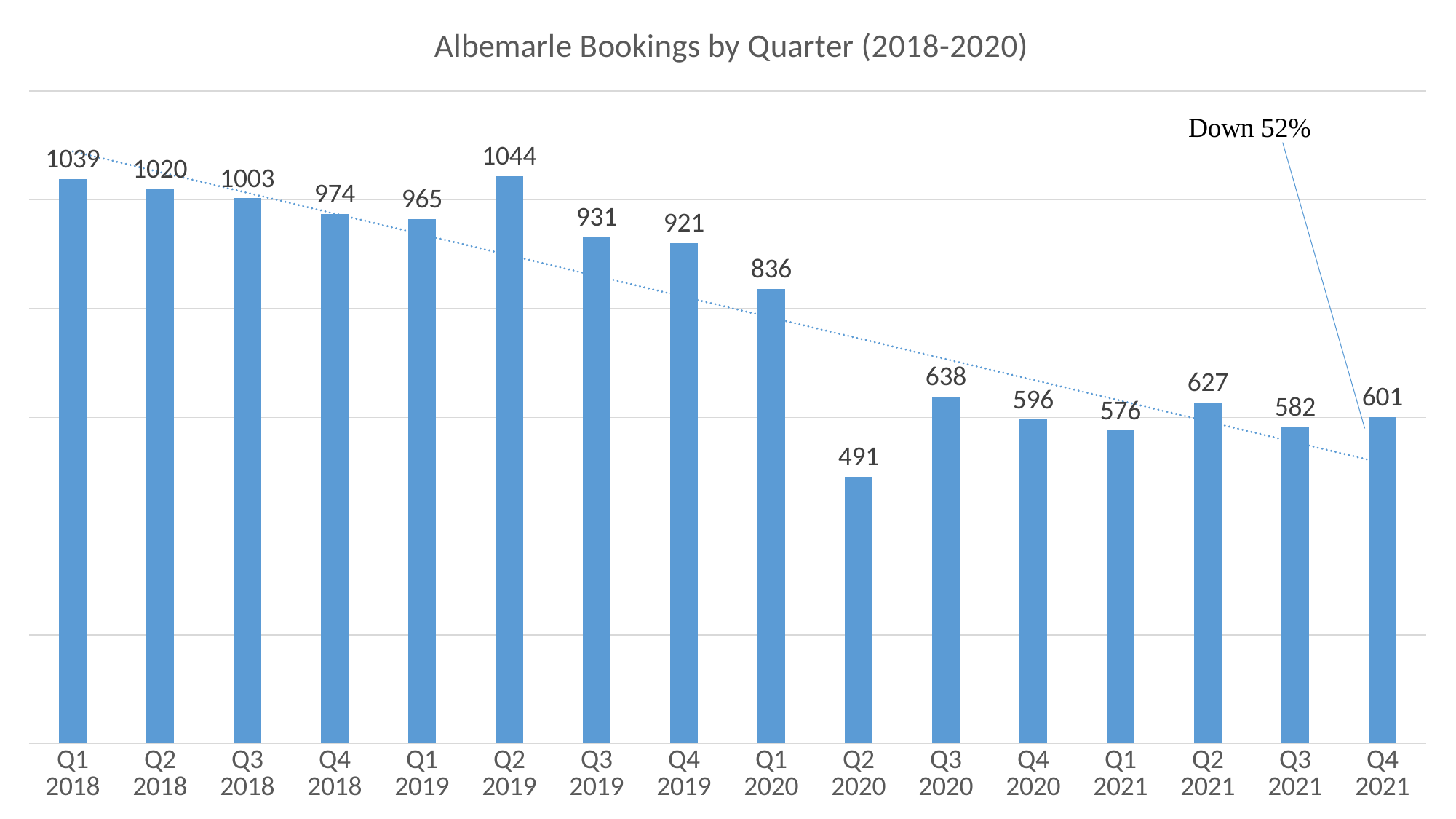
How many quarters are shown on the chart? 16 Which quarter has the highest bookings? Q2 2019 What is the difference between Q1 2020 and Q2 2020? 345 What is the title of the chart? Albemarle Bookings by Quarter (2018-2020) Do the bookings generally rise or fall from Q1 2018 to Q4 2021? Fall What kind of chart is this? Bar chart What is the value for Q2 2020? 491 Which quarter has the lowest bookings? Q2 2020 Which is larger, Q3 2020 or Q2 2021? Q3 2020 What is the difference between Q1 2018 and Q4 2021? 438 What is the value for Q1 2018? 1039 What is the value for Q4 2021? 601